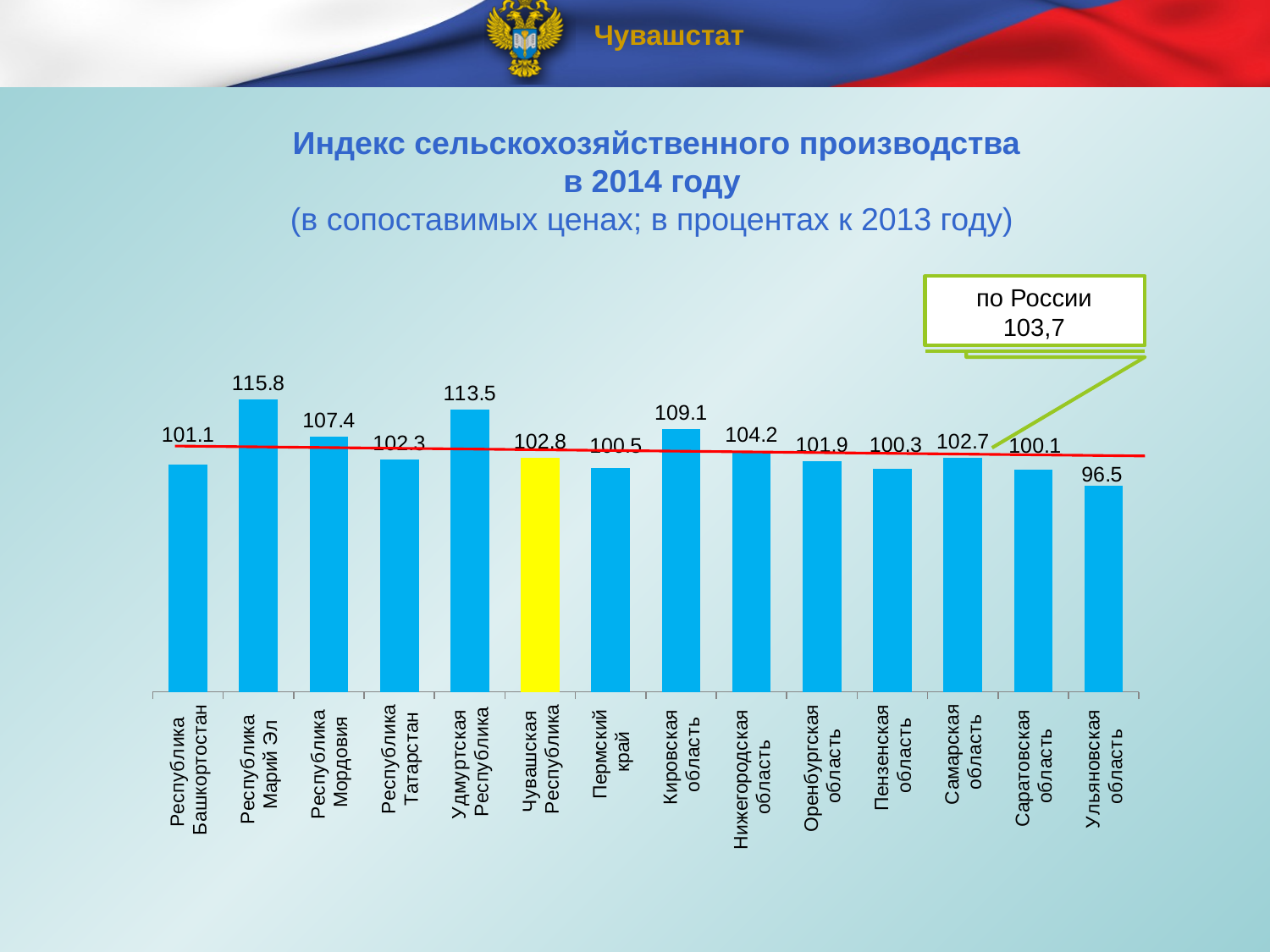
What kind of chart is shown on the slide? bar chart What is the value for Республика Марий Эл? 115.8 What is the value for Чувашская Республика? 102.8 Which is larger, the value for Республика Мордовия or the value for Нижегородская область? Республика Мордовия Which region has the highest value? Республика Марий Эл What is the value for Ульяновская область? 96.5 What value for Russia as a whole (по России) is shown in the callout box? 103,7 How many regions are shown in the chart? 14 What is the difference between the values for Удмуртская Республика and Кировская область? 4.4 Which bar is highlighted in yellow? Чувашская Республика What is the value for Пензенская область? 100.3 Which region has the lowest value? Ульяновская область